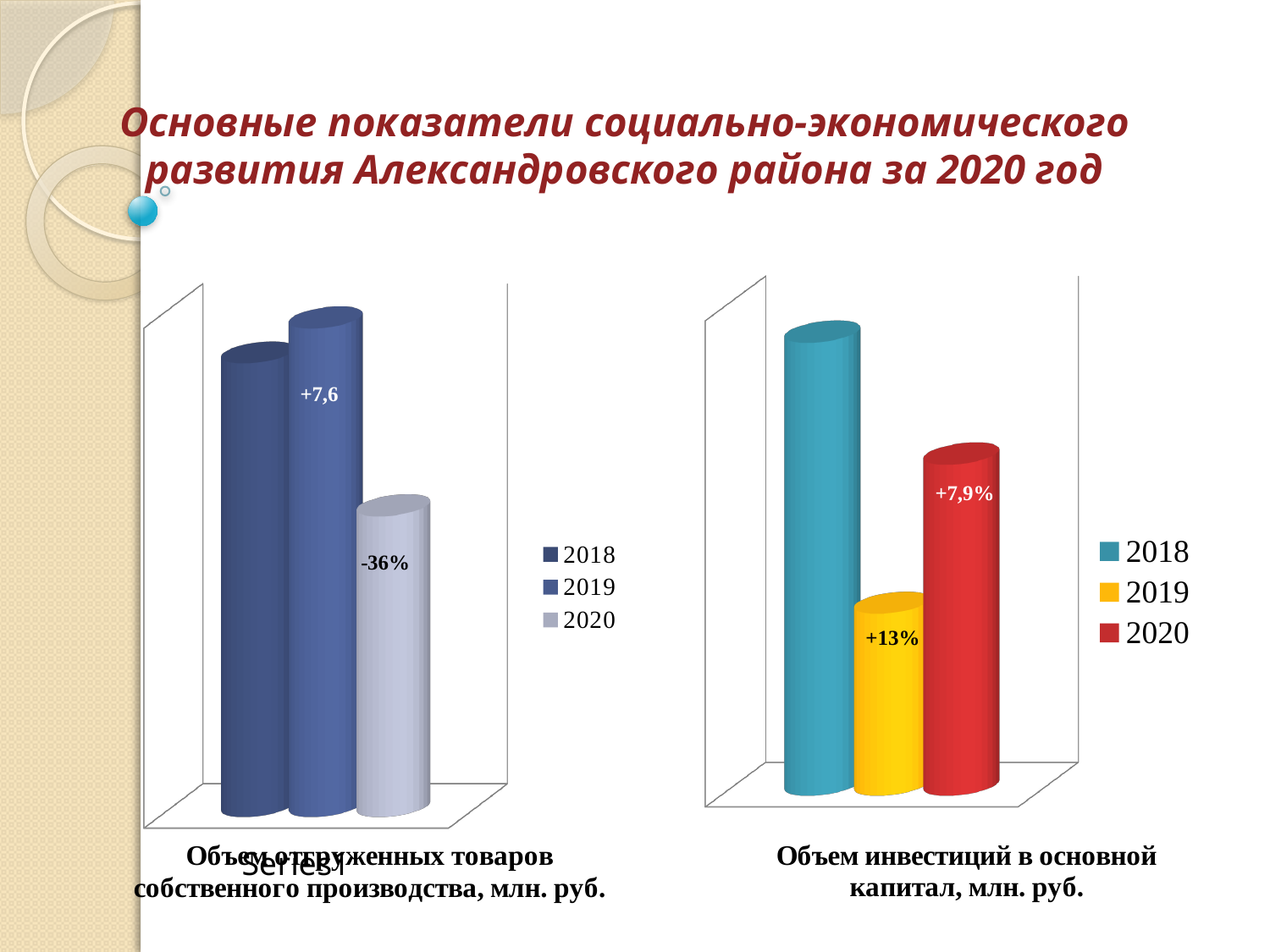
In the right chart, 'Объем инвестиций в основной капитал', what label is printed on the 2019 bar? +13% In the left chart, 'Объем отгруженных товаров собственного производства', which year has the tallest bar? 2019 In the right chart, 'Объем инвестиций в основной капитал', which year has the tallest bar? 2018 In the right chart, 'Объем инвестиций в основной капитал', how many series does the legend list? 3 In the right chart, 'Объем инвестиций в основной капитал', what label is printed on the 2020 bar? +7,9% In the left chart, 'Объем отгруженных товаров собственного производства', which year has the shortest bar? 2020 In the left chart, 'Объем отгруженных товаров собственного производства', how many series does the legend list? 3 In the right chart, 'Объем инвестиций в основной капитал', which year has the shortest bar? 2019 What kind of chart is the right chart, 'Объем инвестиций в основной капитал, млн. руб.'? bar chart In the left chart, 'Объем отгруженных товаров собственного производства', what label is printed on the 2019 bar? +7,6 What kind of chart is the left chart, 'Объем отгруженных товаров собственного производства, млн. руб.'? bar chart In the left chart, 'Объем отгруженных товаров собственного производства', what label is printed on the 2020 bar? -36%